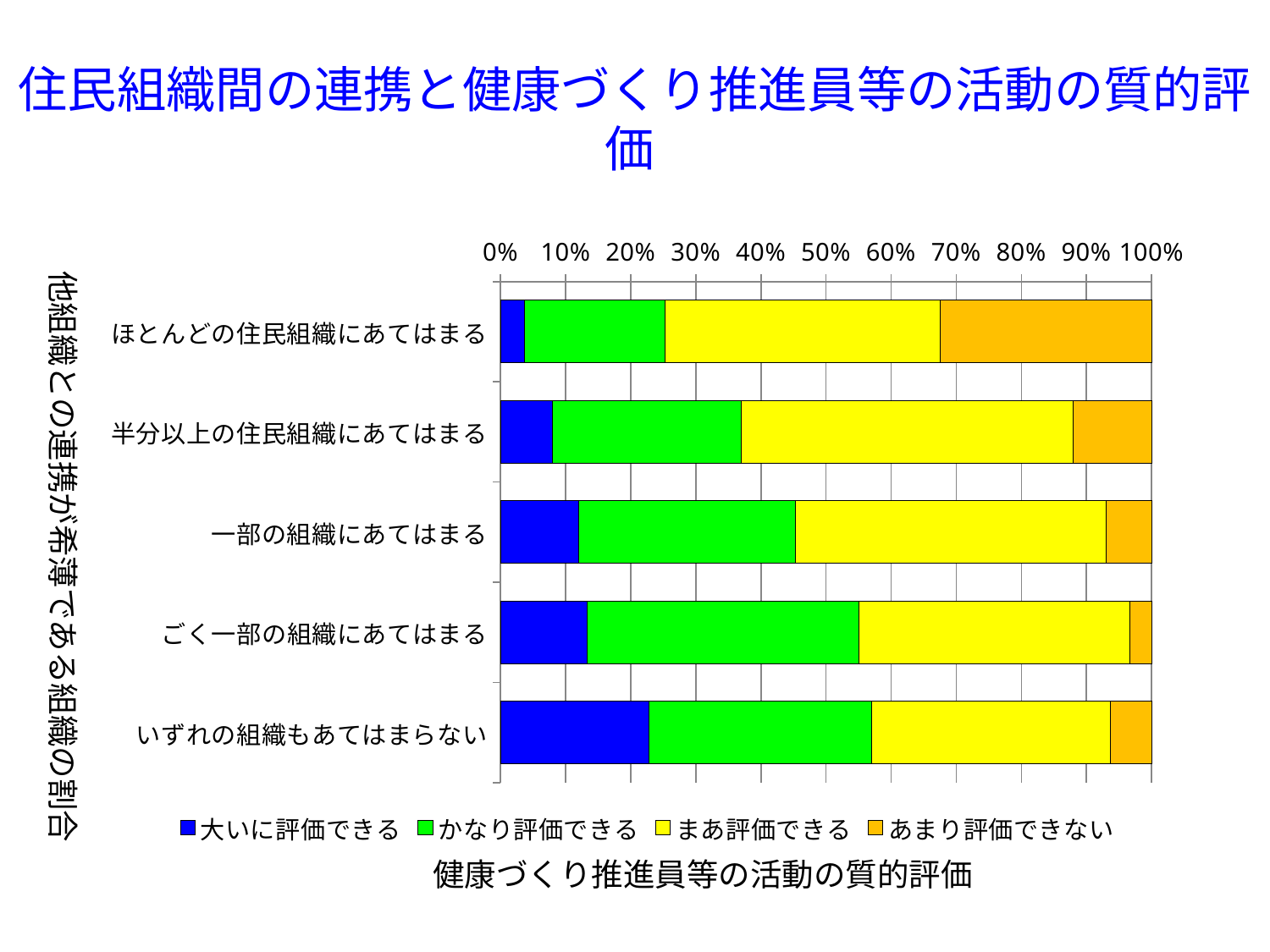
Which category has the smallest あまり評価できない segment? ごく一部の組織にあてはまる What is the title shown below the chart's horizontal axis? 健康づくり推進員等の活動の質的評価 What kind of chart is shown on the slide? Stacked bar chart Which category has the largest 大いに評価できる segment? いずれの組織もあてはまらない Which has the larger 大いに評価できる segment: 半分以上の住民組織にあてはまる or いずれの組織もあてはまらない? いずれの組織もあてはまらない Is the 大いに評価できる share for いずれの組織もあてはまらない greater or less than 20%? greater Going down the categories from ほとんどの住民組織にあてはまる to いずれの組織もあてはまらない, does the 大いに評価できる share rise or fall? rise How many series does the chart's legend list? 4 Is the あまり評価できない share for ほとんどの住民組織にあてはまる greater or less than 20%? greater Which category has the largest あまり評価できない segment? ほとんどの住民組織にあてはまる Which category has the smallest 大いに評価できる segment? ほとんどの住民組織にあてはまる How many categories are plotted on the vertical axis of the chart? 5